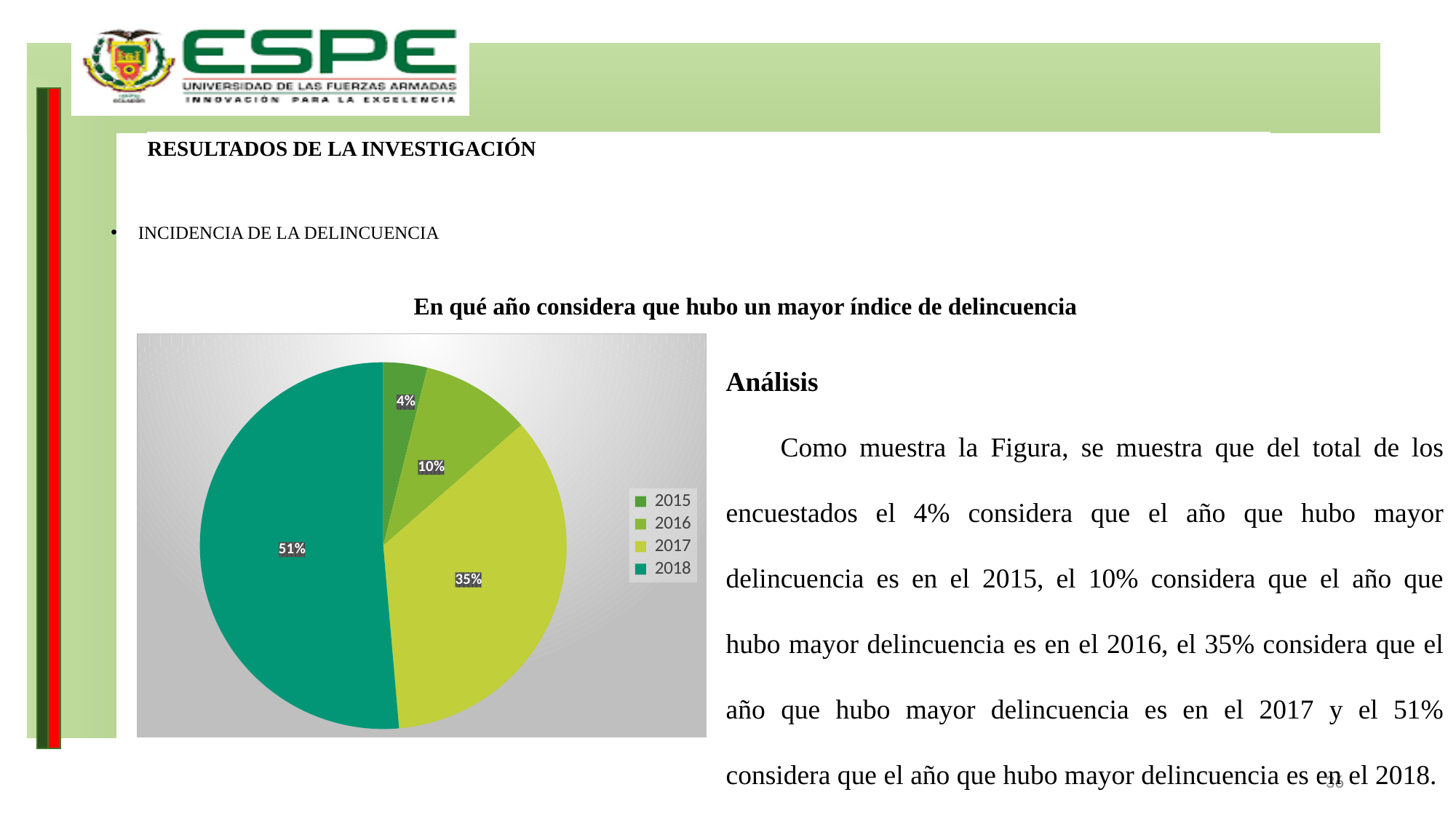
How many entries does the legend list? 4 What kind of chart is shown on the slide? pie chart What share of the pie does 2018 represent? 51% What is the title of the chart? En qué año considera que hubo un mayor índice de delincuencia How many slices does the pie chart have? 4 What share of the pie does 2017 represent? 35% What is the difference in percentage points between the 2018 slice and the 2017 slice? 16 What share of the pie does 2015 represent? 4% Which year has the smallest slice of the pie? 2015 Which year has the largest slice of the pie? 2018 Which slice is larger, 2016 or 2017? 2017